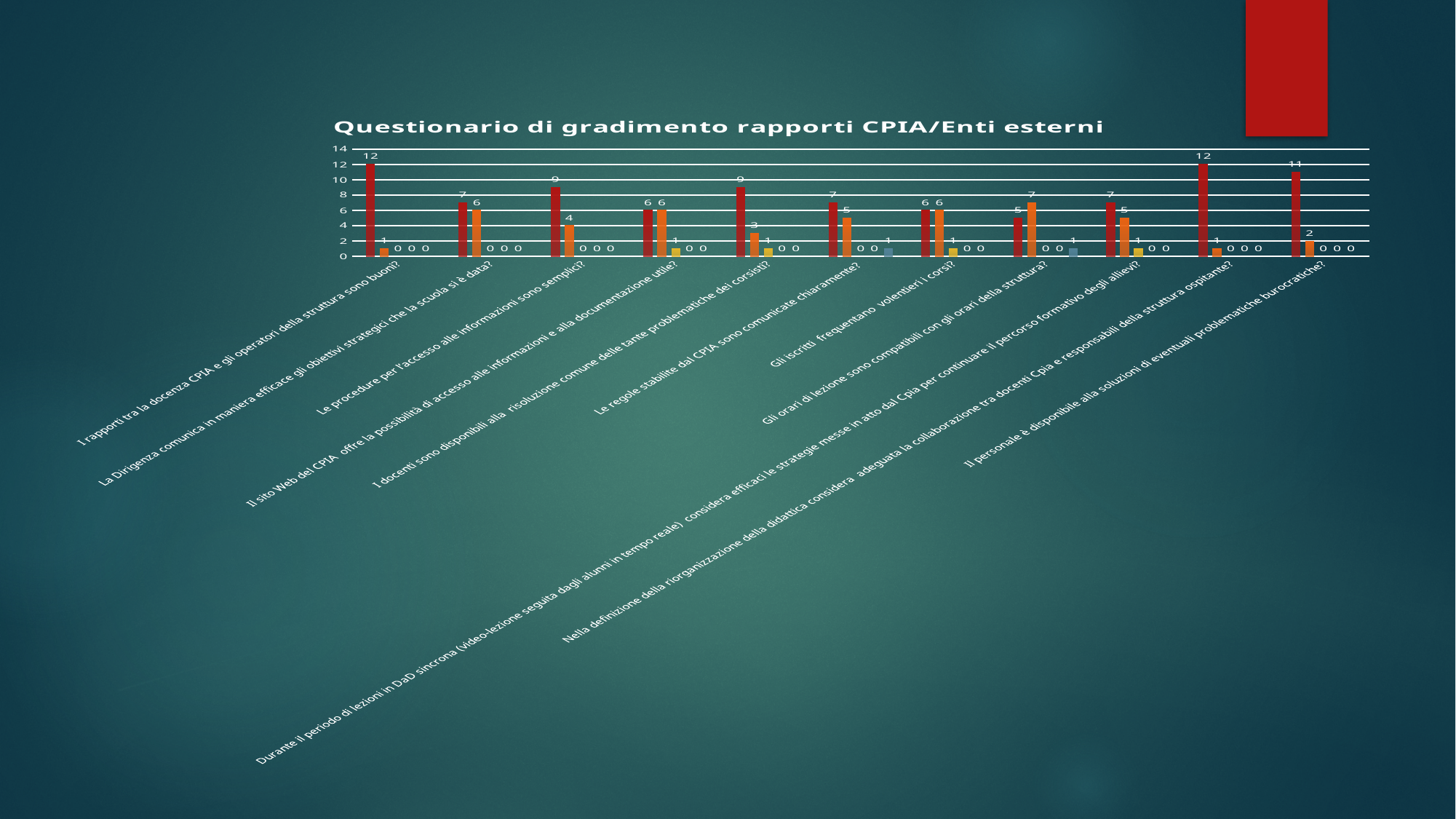
What is the value of the orange bar for "Gli orari di lezione sono compatibili con gli orari della struttura?"? 7 What is the maximum value shown on the chart's vertical axis? 14 What is the title of the chart? Questionario di gradimento rapporti CPIA/Enti esterni What is the value of the dark red bar for "Il personale è disponibile alla soluzioni di eventuali problematiche burocratiche?"? 11 What type of chart is shown on the slide? bar chart What is the value of the orange bar for "Le procedure per l'accesso alle informazioni sono semplici?"? 4 What is the difference between the dark red bar and the orange bar for "Le procedure per l'accesso alle informazioni sono semplici?"? 5 What is the difference between the dark red bar and the orange bar for "I docenti sono disponibili alla risoluzione comune delle tante problematiche dei corsisti?"? 6 For "Gli orari di lezione sono compatibili con gli orari della struttura?", which is larger, the dark red bar or the orange bar? the orange bar How many question categories are shown along the x axis of the chart? 11 What is the highest value shown on the chart? 12 What is the value of the dark red bar for "I rapporti tra la docenza CPIA e gli operatori della struttura sono buoni?"? 12